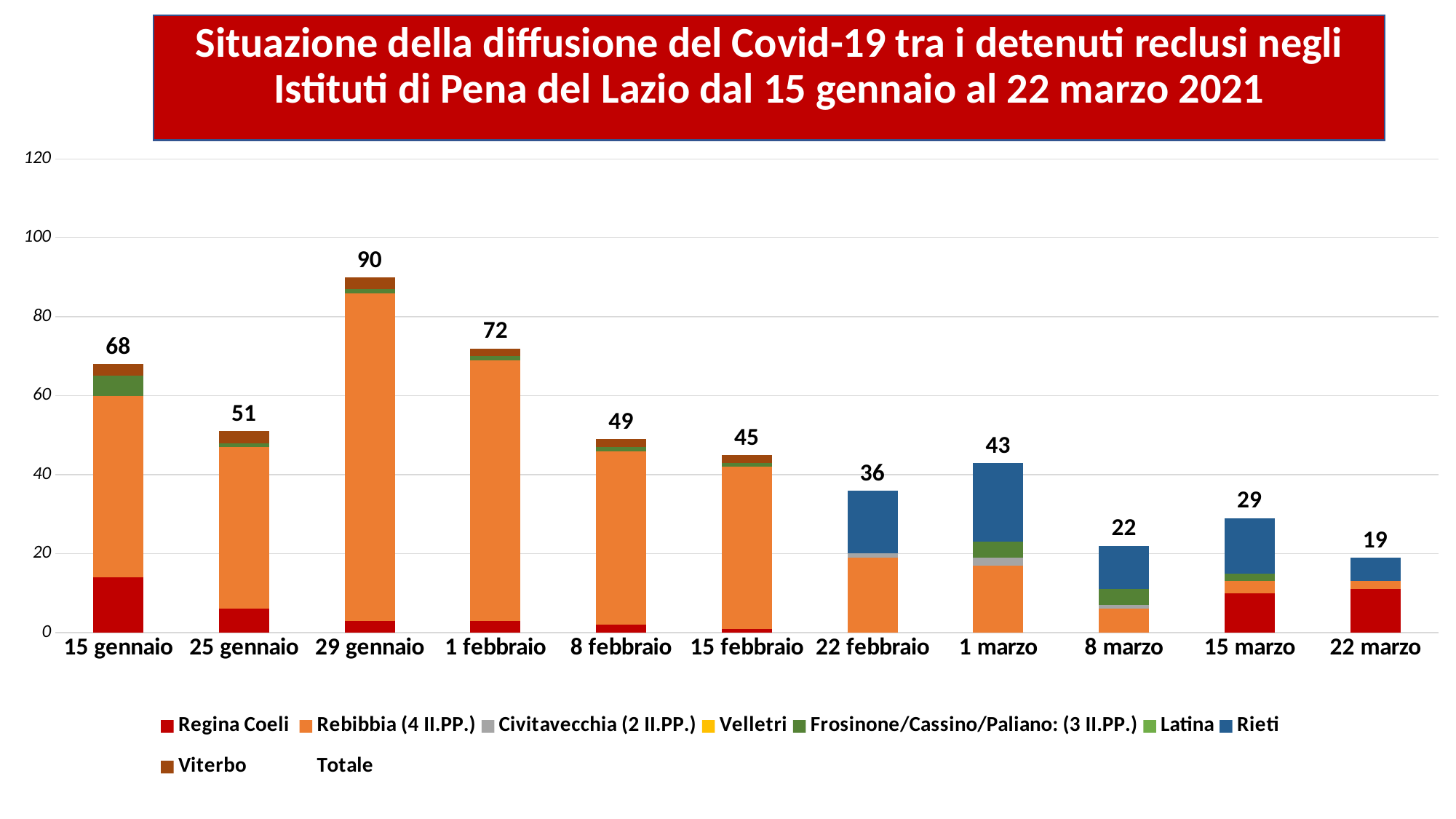
What kind of chart is shown on the slide? Stacked bar chart Which date has the lowest total? 22 marzo Which colour represents Rieti in the chart? Blue What is the total value shown for 29 gennaio? 90 Is the Regina Coeli value for 15 gennaio greater or less than 20? less How many dates are shown on the x axis? 11 How many entries does the legend list? 9 Which date has the highest total? 29 gennaio What is the difference between the totals for 29 gennaio and 1 febbraio? 18 Which has a larger total, 1 marzo or 15 marzo? 1 marzo What is the total value shown for 22 febbraio? 36